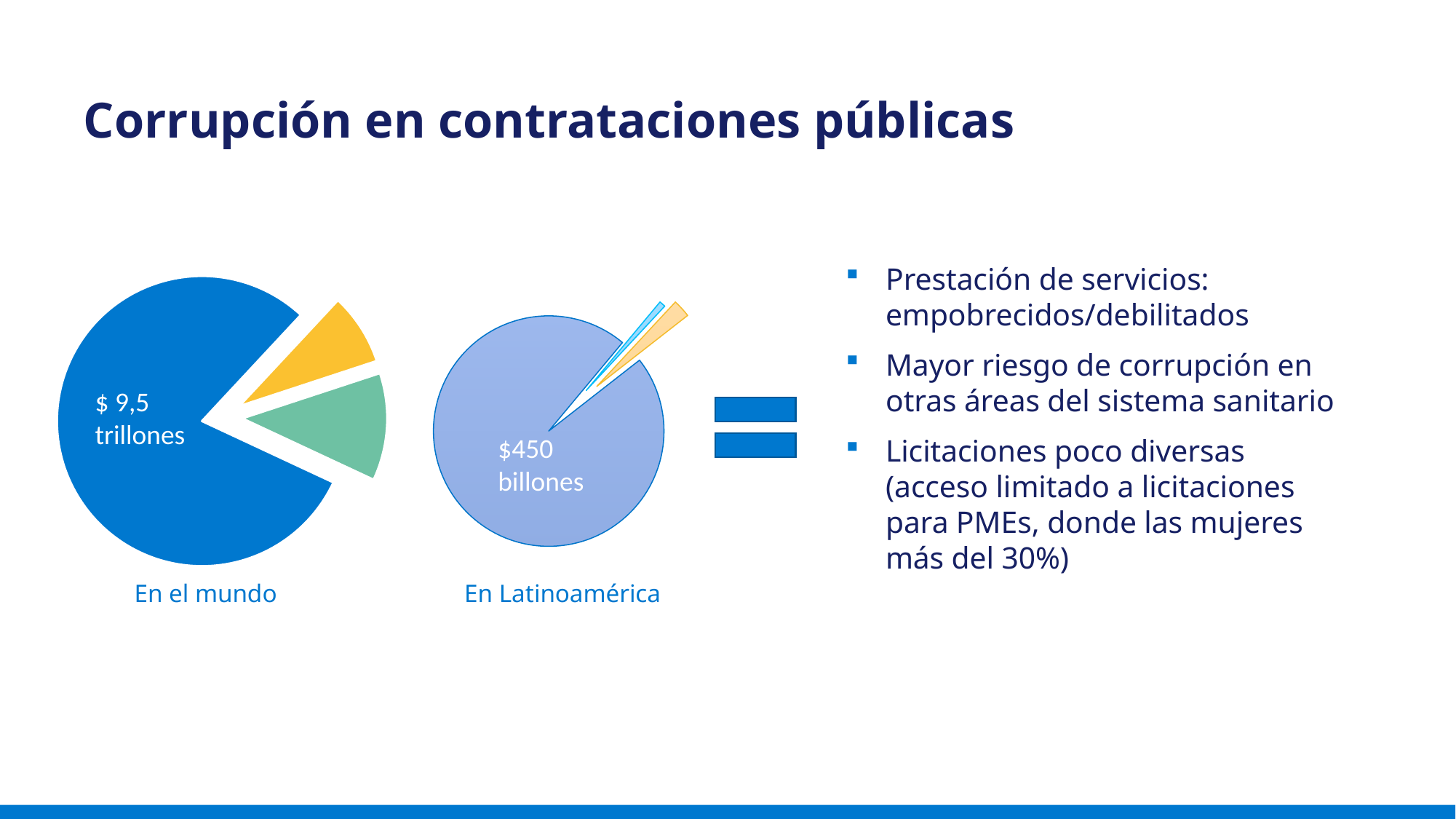
What is the label under the left pie chart? En el mundo What kind of chart is the "En el mundo" chart? pie chart In the "En Latinoamérica" chart, is the large labelled slice larger or smaller than the thin yellow slice? larger What kind of chart is the "En Latinoamérica" chart? pie chart In the "En el mundo" chart, is the blue slice larger or smaller than the yellow slice? larger In the "En el mundo" chart, which slice is the largest? the blue slice ($ 9,5 trillones) In the "En Latinoamérica" chart, what value is printed on the large slice? $450 billones How many slices does the "En el mundo" pie chart have? 3 What is the label under the right pie chart? En Latinoamérica How many slices does the "En Latinoamérica" pie chart have? 3 In the "En el mundo" chart, what value is printed on the large blue slice? $ 9,5 trillones